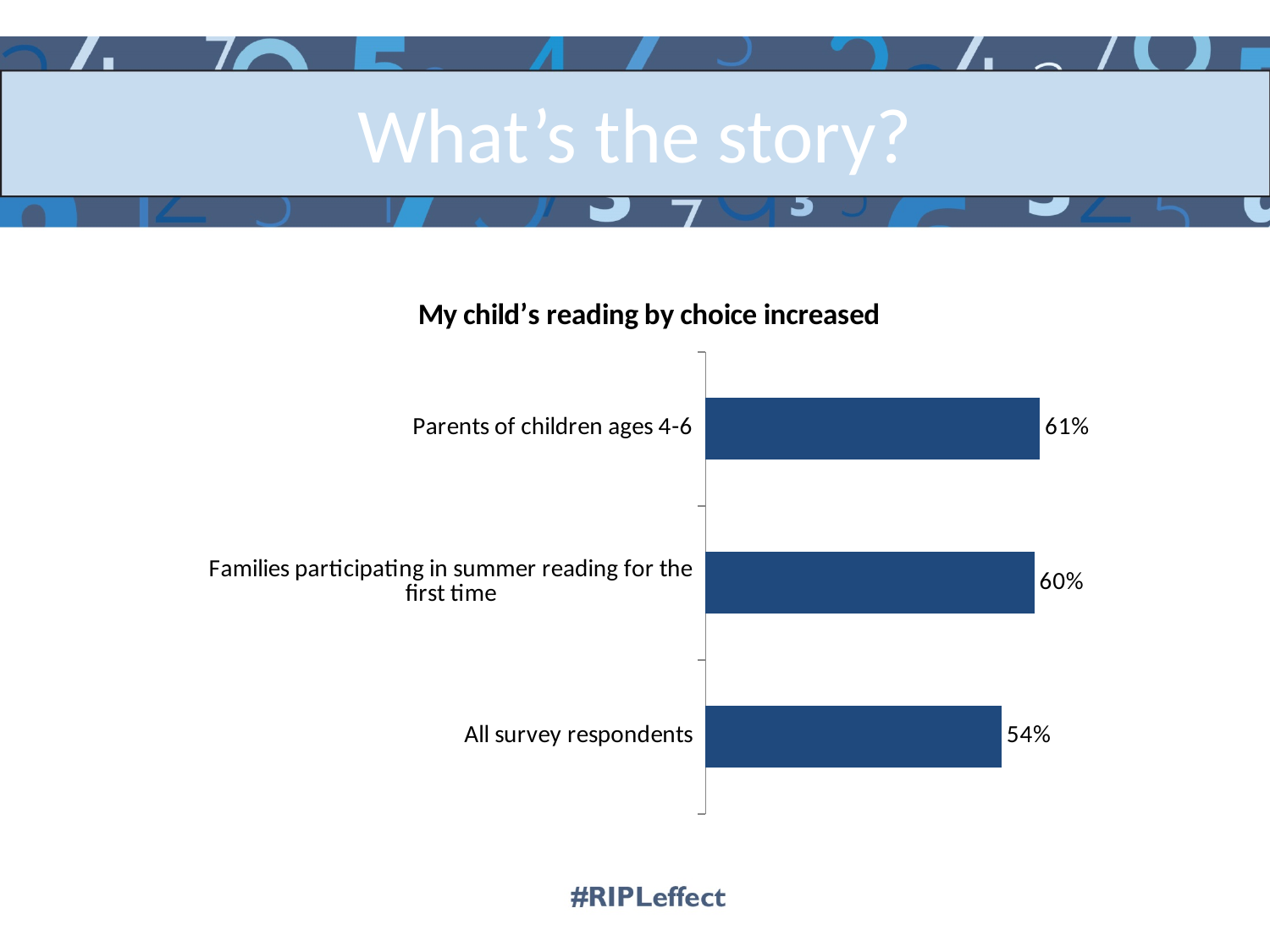
Which category has the lowest value? All survey respondents What is the title of the chart? My child's reading by choice increased How many categories are shown in the chart? 3 What is the value for Families participating in summer reading for the first time? 60% What colour are the bars in the chart? Dark blue What is the difference between the value for Parents of children ages 4-6 and the value for All survey respondents? 7% What is the value for All survey respondents? 54% What is the difference between the value for Families participating in summer reading for the first time and the value for All survey respondents? 6% What kind of chart is shown on the slide? Bar chart Which category has the highest value? Parents of children ages 4-6 Which is larger: the value for Families participating in summer reading for the first time or the value for All survey respondents? Families participating in summer reading for the first time What is the value for Parents of children ages 4-6? 61%